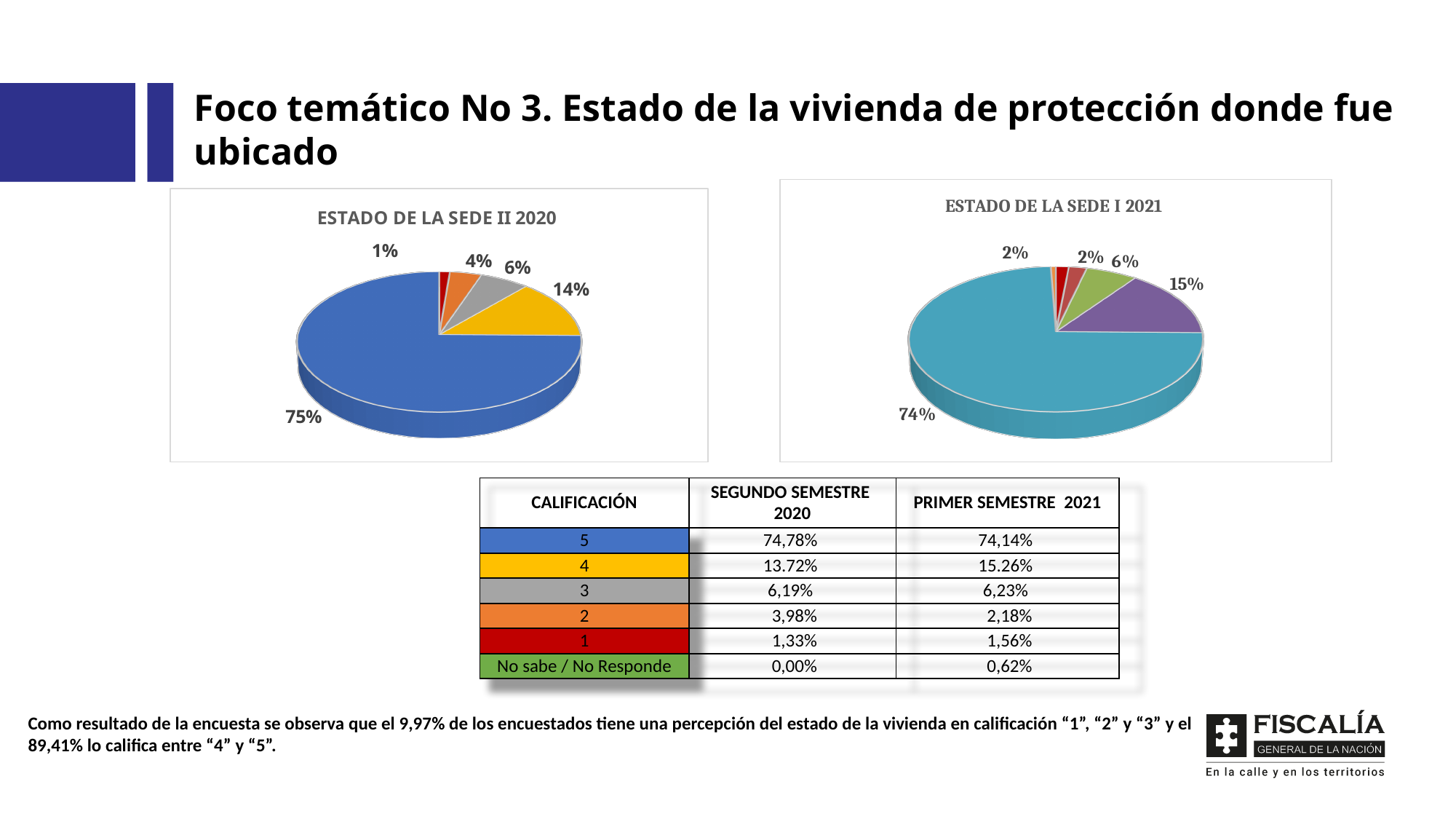
In the chart 'ESTADO DE LA SEDE II 2020', what is the difference between the largest slice and the yellow slice? 61 percentage points In the chart 'ESTADO DE LA SEDE II 2020', what is the value of the gray slice? 6% In the chart 'ESTADO DE LA SEDE II 2020', what is the value of the yellow slice? 14% In the chart 'ESTADO DE LA SEDE II 2020', what is the value of the orange slice? 4% In the chart 'ESTADO DE LA SEDE II 2020', what is the value of the largest slice? 75% What kind of chart is the chart titled 'ESTADO DE LA SEDE II 2020'? Pie chart How many slices have data labels in the chart 'ESTADO DE LA SEDE II 2020'? 5 In the chart 'ESTADO DE LA SEDE I 2021', what is the value of the largest slice? 74% What is the title of the pie chart on the right side of the slide? ESTADO DE LA SEDE I 2021 In the chart 'ESTADO DE LA SEDE I 2021', what is the value of the purple slice? 15% In the chart 'ESTADO DE LA SEDE II 2020', what is the value of the smallest labeled slice? 1% Which chart has the larger biggest slice, 'ESTADO DE LA SEDE II 2020' or 'ESTADO DE LA SEDE I 2021'? ESTADO DE LA SEDE II 2020